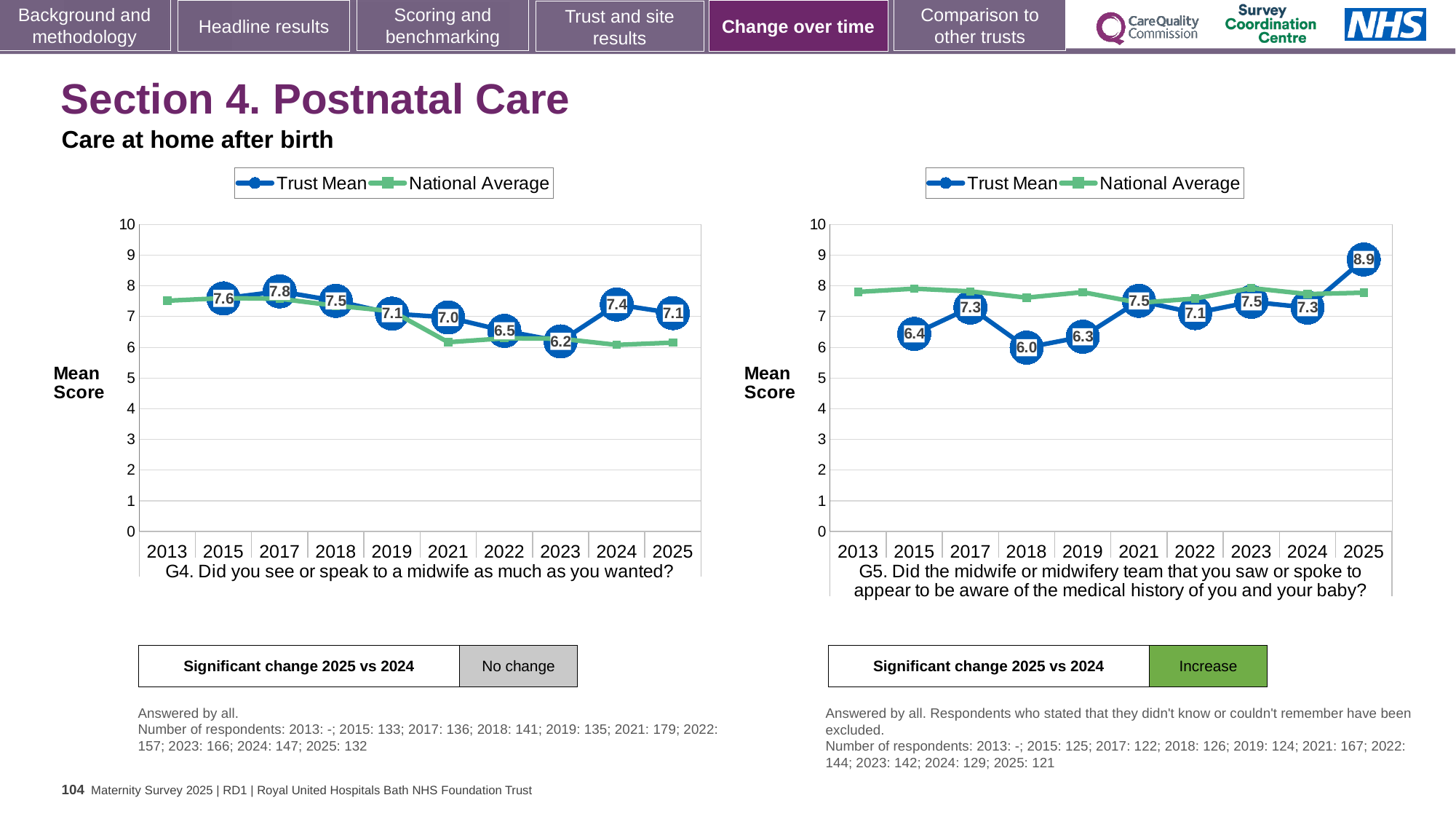
In the G5 chart (right), is the National Average for 2013 greater or less than 7? greater How many series does the legend of the G5 chart (right) list? 2 In the G5 chart (right), which year has the lowest Trust Mean? 2018 How many years are shown on the x axis of the G4 chart (left)? 10 In the G5 chart (right), does the Trust Mean rise or fall from 2024 to 2025? Rise In the G4 chart (left), which year has the lowest Trust Mean? 2023 In the G5 chart (right), what is the difference between the Trust Mean for 2025 and 2024? 1.6 In the G4 chart (left), what is the Trust Mean for 2025? 7.1 What kind of chart is the G4 chart (left)? Line chart In the G5 chart (right), what is the Trust Mean for 2025? 8.9 In the G4 chart (left), which is larger, the Trust Mean for 2024 or for 2025? 2024 In the G4 chart (left), which year has the highest Trust Mean? 2017